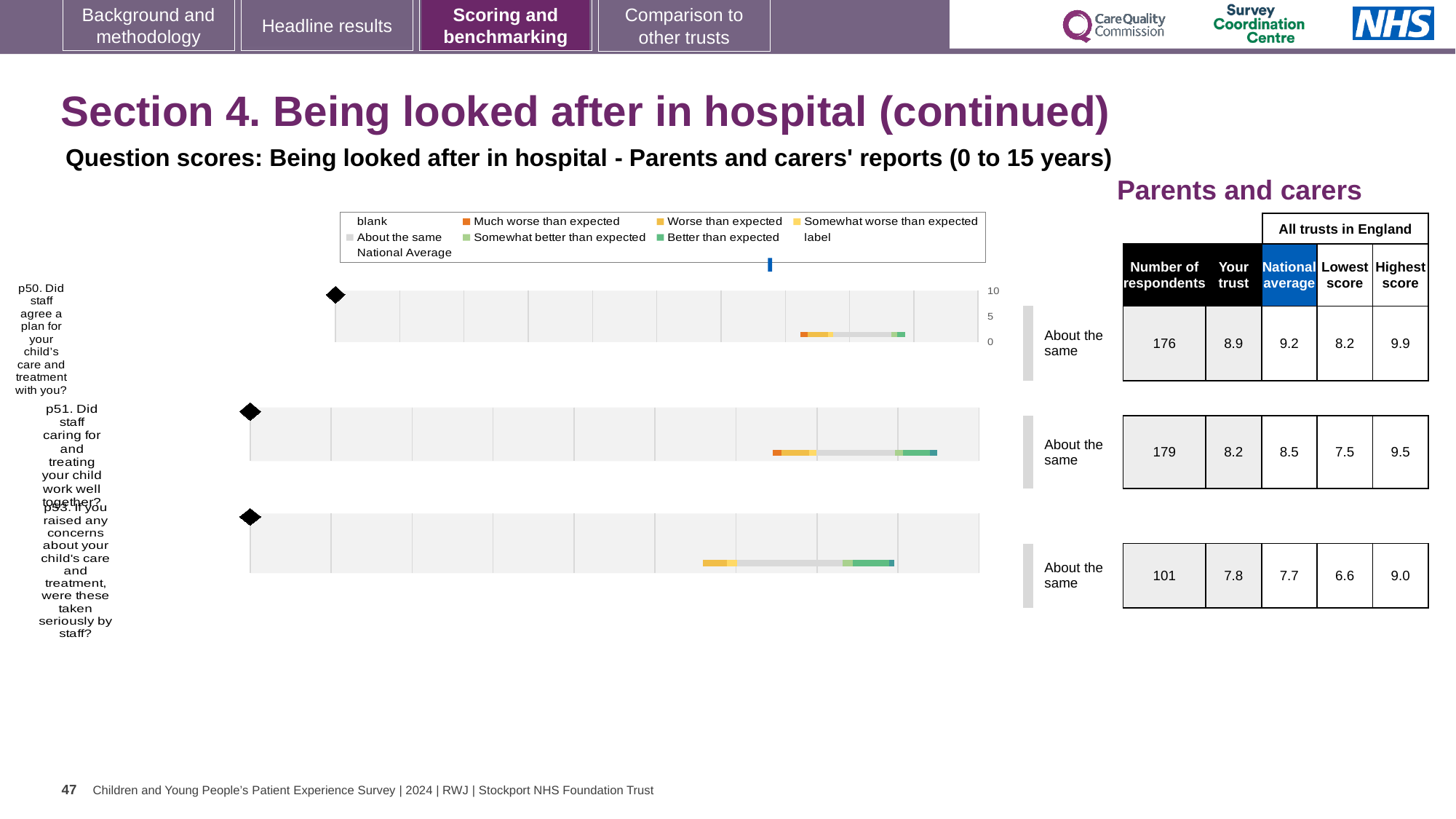
What is the national average score for p51 (Did staff caring for and treating your child work well together)? 8.5 How many respondents answered p53 (If you raised any concerns about your child's care and treatment, were these taken seriously by staff)? 101 How many entries does the chart legend list? 9 What is the difference between the highest score and the lowest score for p51? 2.0 What is the highest score among all trusts in England for p50? 9.9 What kind of chart is used to show the question scores on this slide? bar chart What benchmark category is shown for all three questions on this slide? About the same Which question has the highest 'Your trust' score? p50 What is the 'Your trust' score for p50 (Did staff agree a plan for your child's care and treatment with you)? 8.9 Which question has the lowest 'Your trust' score? p53 For p53, is the 'Your trust' score or the national average higher? Your trust How many questions (chart rows) are plotted on this slide? 3